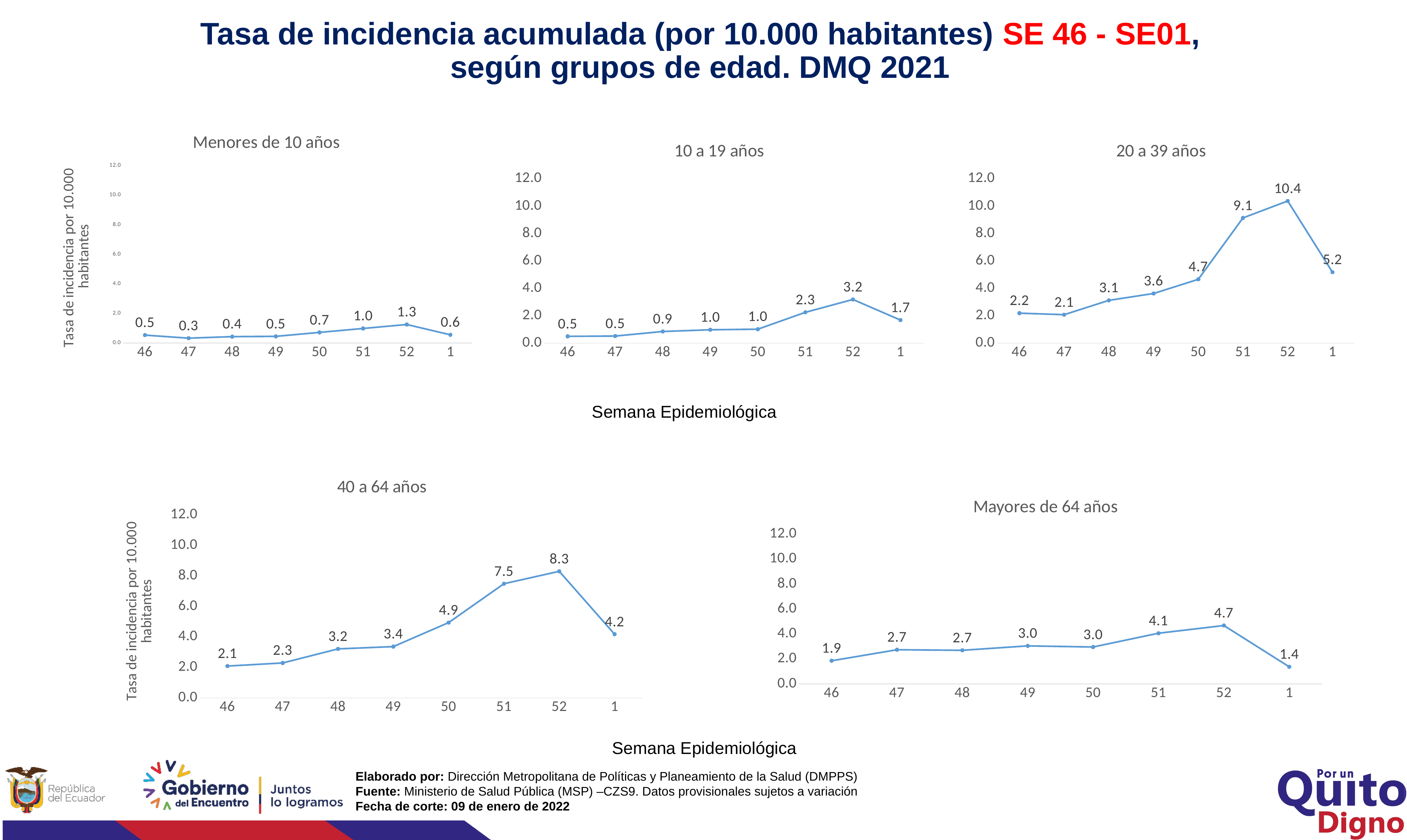
In the '40 a 64 años' chart, which is larger: the value for week 51 or week 1? week 51 In the '20 a 39 años' chart, what is the value for week 52? 10.4 In the 'Menores de 10 años' chart, what is the value for week 47? 0.3 In the '20 a 39 años' chart, what is the difference between the values for week 52 and week 1? 5.2 In the 'Mayores de 64 años' chart, what is the value for week 1? 1.4 How many charts are shown on the slide? 5 What kind of chart is the '10 a 19 años' chart? line chart In the '20 a 39 años' chart, is the value for week 51 greater or less than 8.0? greater In the '40 a 64 años' chart, which week has the highest value? 52 In the '10 a 19 años' chart, which week has the lowest value? 46 and 47 (both 0.5) How many weeks are plotted on the x axis of the 'Mayores de 64 años' chart? 8 In the '40 a 64 años' chart, do the values rise or fall from week 46 to week 52? rise